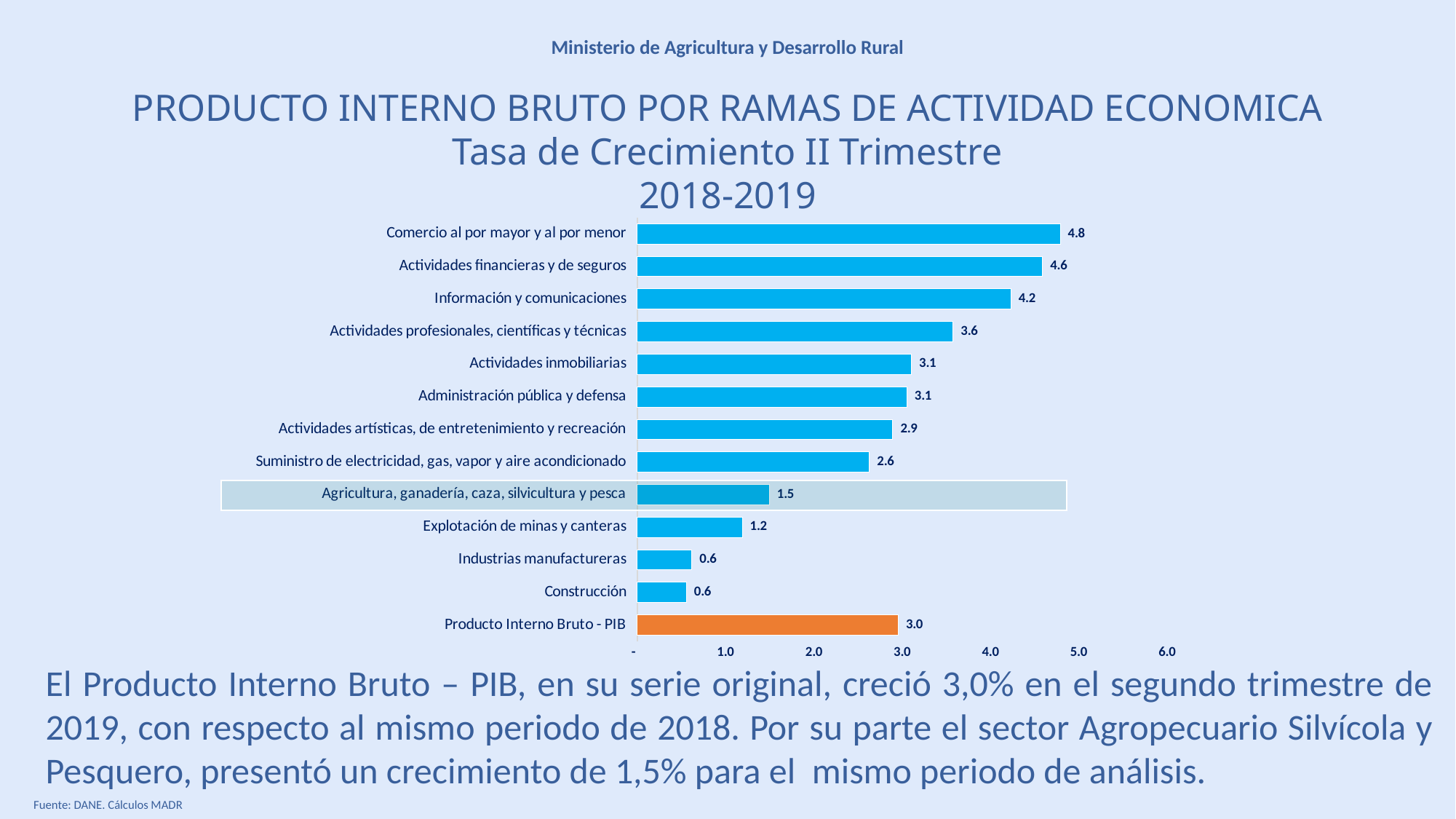
Which category has the highest value? Comercio al por mayor y al por menor What is the difference between Actividades financieras y de seguros and Información y comunicaciones? 0.4 Is the value for Actividades artísticas, de entretenimiento y recreación greater or less than 2.0? greater Which is larger, Actividades profesionales, científicas y técnicas or Suministro de electricidad, gas, vapor y aire acondicionado? Actividades profesionales, científicas y técnicas How many categories are shown in the chart? 13 Which bar is shown in orange rather than blue? Producto Interno Bruto - PIB What is the difference between Producto Interno Bruto - PIB and Agricultura, ganadería, caza, silvicultura y pesca? 1.5 What is the value for Producto Interno Bruto - PIB? 3.0 What is the value for Agricultura, ganadería, caza, silvicultura y pesca? 1.5 What is the value for Comercio al por mayor y al por menor? 4.8 What is the value for Explotación de minas y canteras? 1.2 What kind of chart is shown on the slide? bar chart